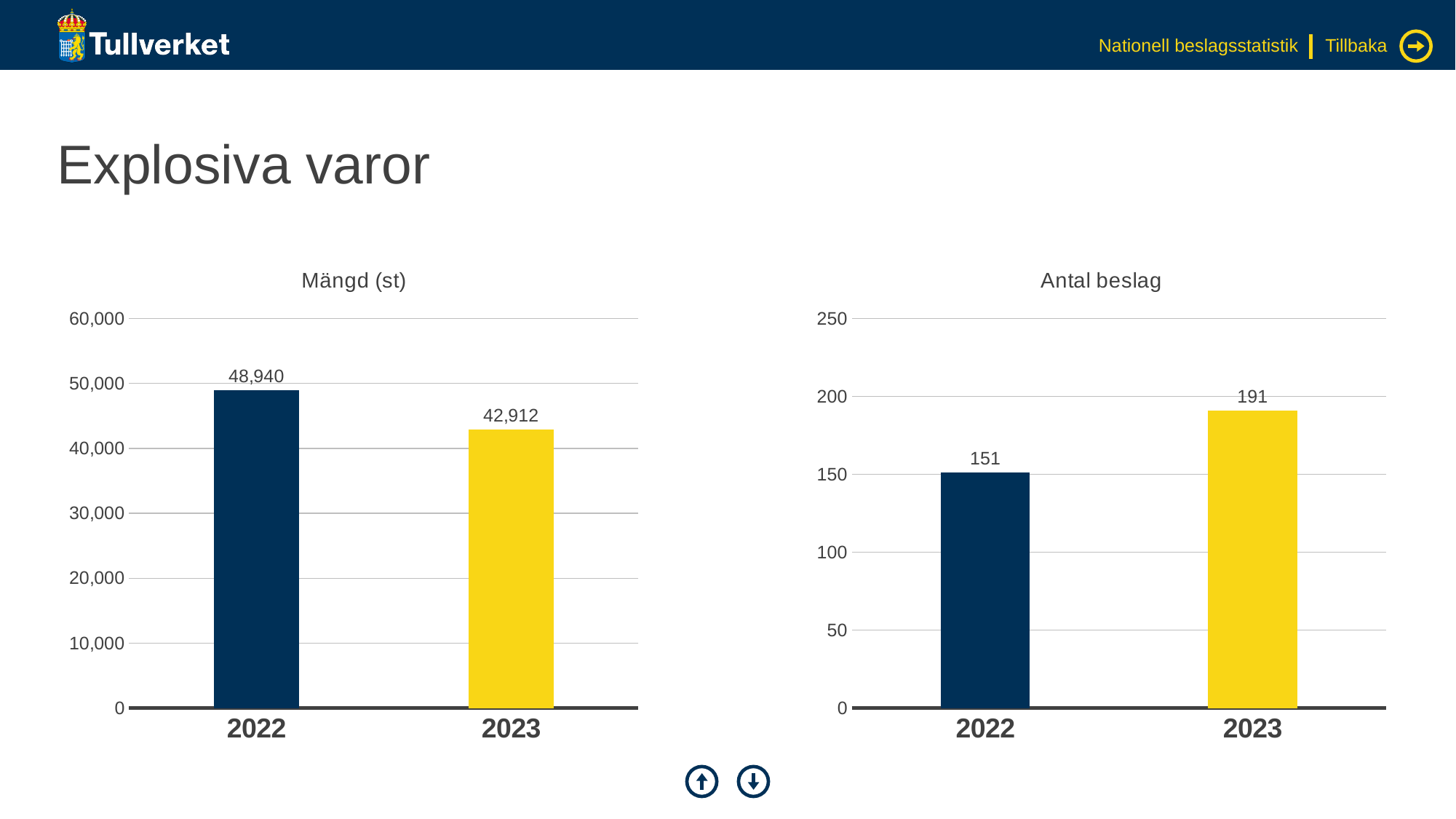
In the 'Mängd (st)' chart, what is the value for 2023? 42,912 In the 'Antal beslag' chart, is the value for 2023 greater or less than 200? less In the 'Mängd (st)' chart, what is the difference between the 2022 and 2023 values? 6,028 In the 'Antal beslag' chart, what is the difference between the 2023 and 2022 values? 40 In the 'Mängd (st)' chart, which year has the highest value? 2022 In the 'Antal beslag' chart, what is the value for 2023? 191 In the 'Mängd (st)' chart, do the values rise or fall from 2022 to 2023? fall In the 'Antal beslag' chart, what is the value for 2022? 151 What kind of chart is the 'Antal beslag' chart? bar chart In the 'Antal beslag' chart, which year has the lowest value? 2022 How many years are shown in the 'Mängd (st)' chart? 2 In the 'Mängd (st)' chart, what is the value for 2022? 48,940